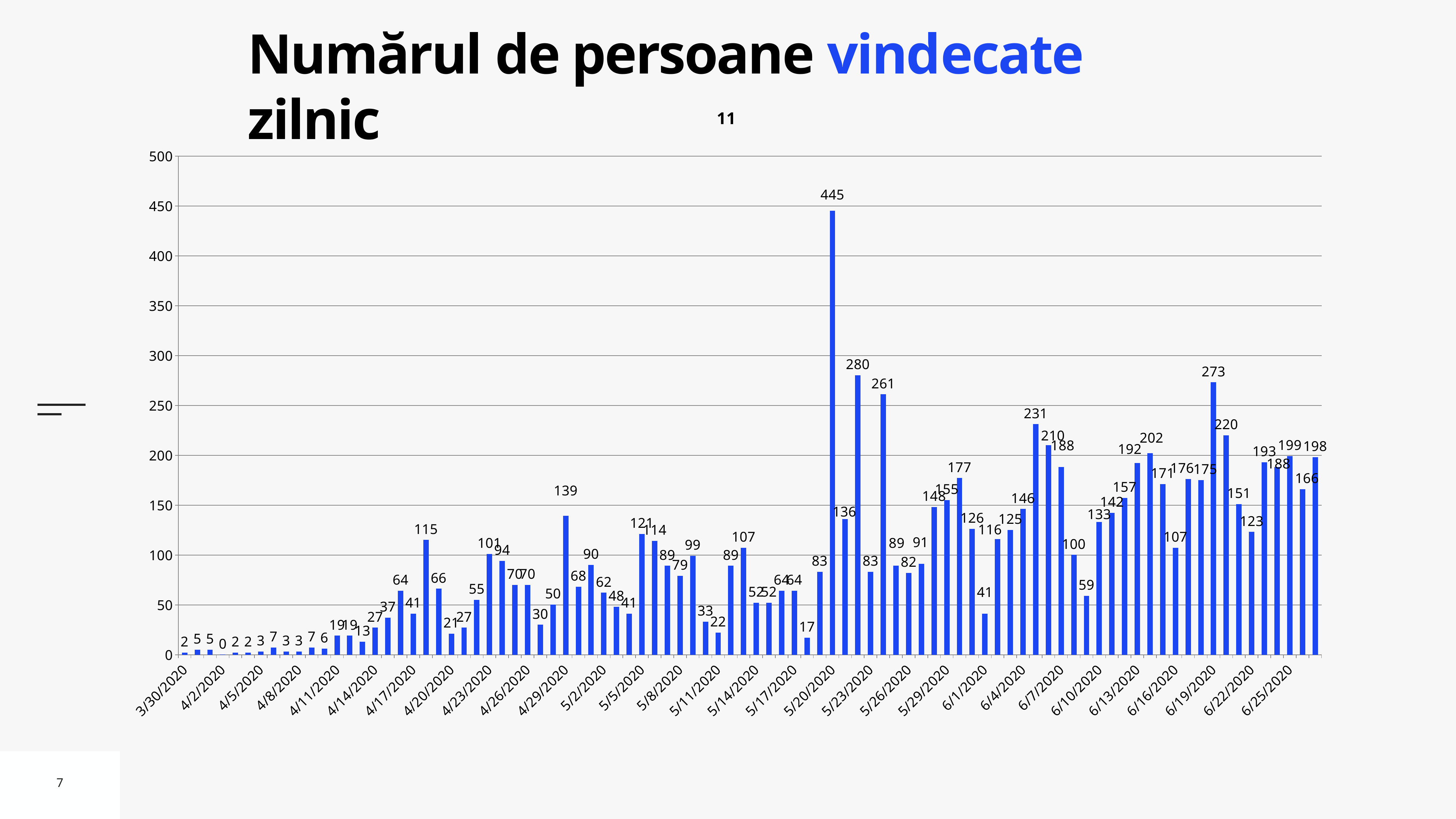
Overall, do the values rise or fall from 3/30/2020 to 6/25/2020? rise What is the value for 4/2/2020? 0 What is the title of the slide's chart? 11 Which is larger, the value for 6/13/2020 or the value for 6/25/2020? 6/25/2020 What is the difference between the values for 5/20/2020 and 6/19/2020? 172 What is the value for 6/25/2020? 199 Is the value for 6/7/2020 greater or less than 150? greater On which date is the number of recovered persons highest? 5/20/2020 What is the value for 4/29/2020? 139 What is the value for 5/20/2020? 445 What type of chart is shown on the slide? bar chart What is the value for 6/19/2020? 273